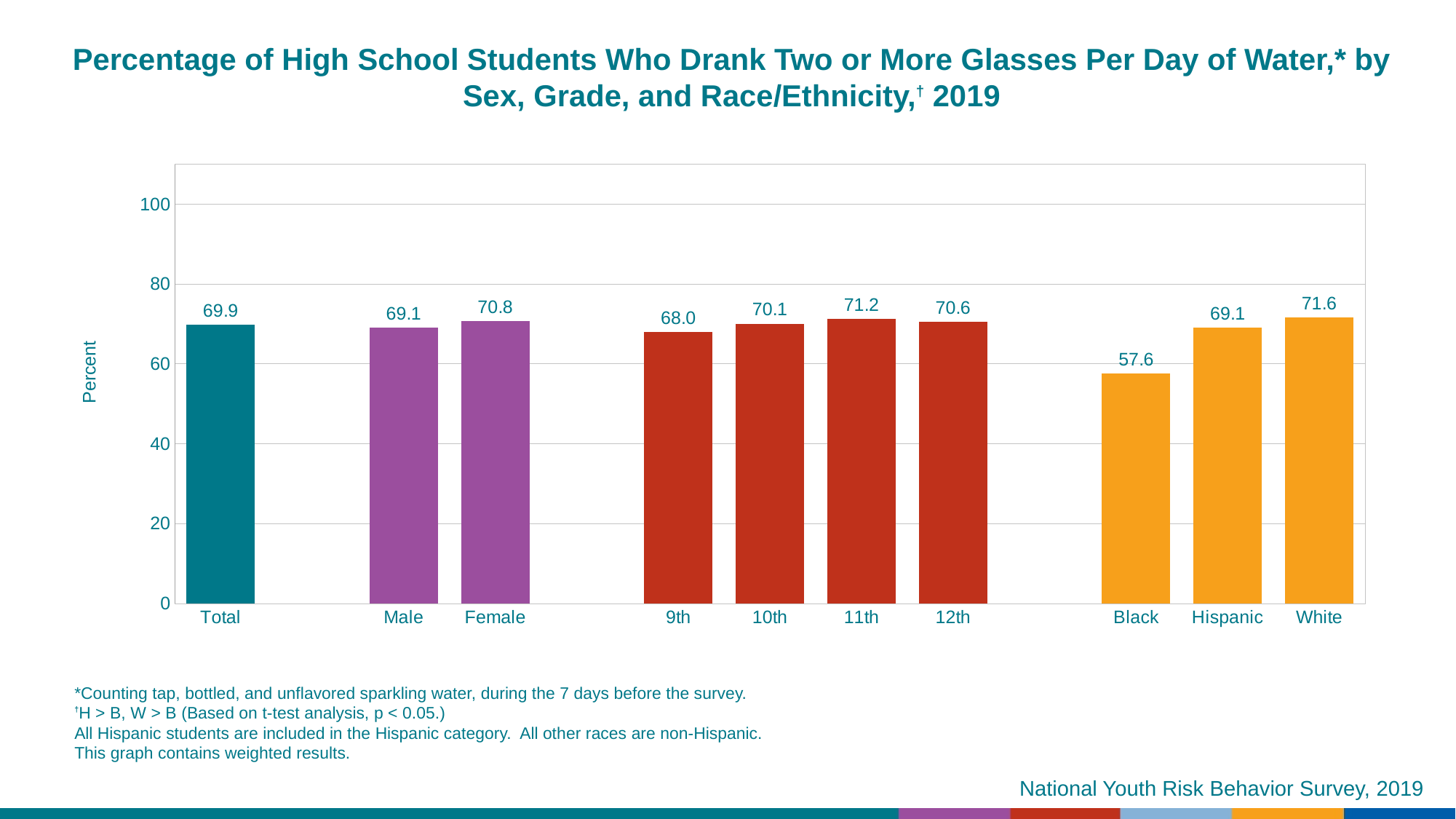
What is the value for Black students? 57.6 What is the value for 11th grade? 71.2 Which category has the lowest value? Black What is the difference between the values for White and Black? 14.0 Which category has the highest value? White What is the value for Total? 69.9 How many categories are shown on the x axis? 10 Is the value for Black greater or less than 60? less What kind of chart is this? bar chart What is the label on the y axis? Percent Which is larger, the value for 9th grade or 12th grade? 12th What is the difference between the values for Female and Male? 1.7